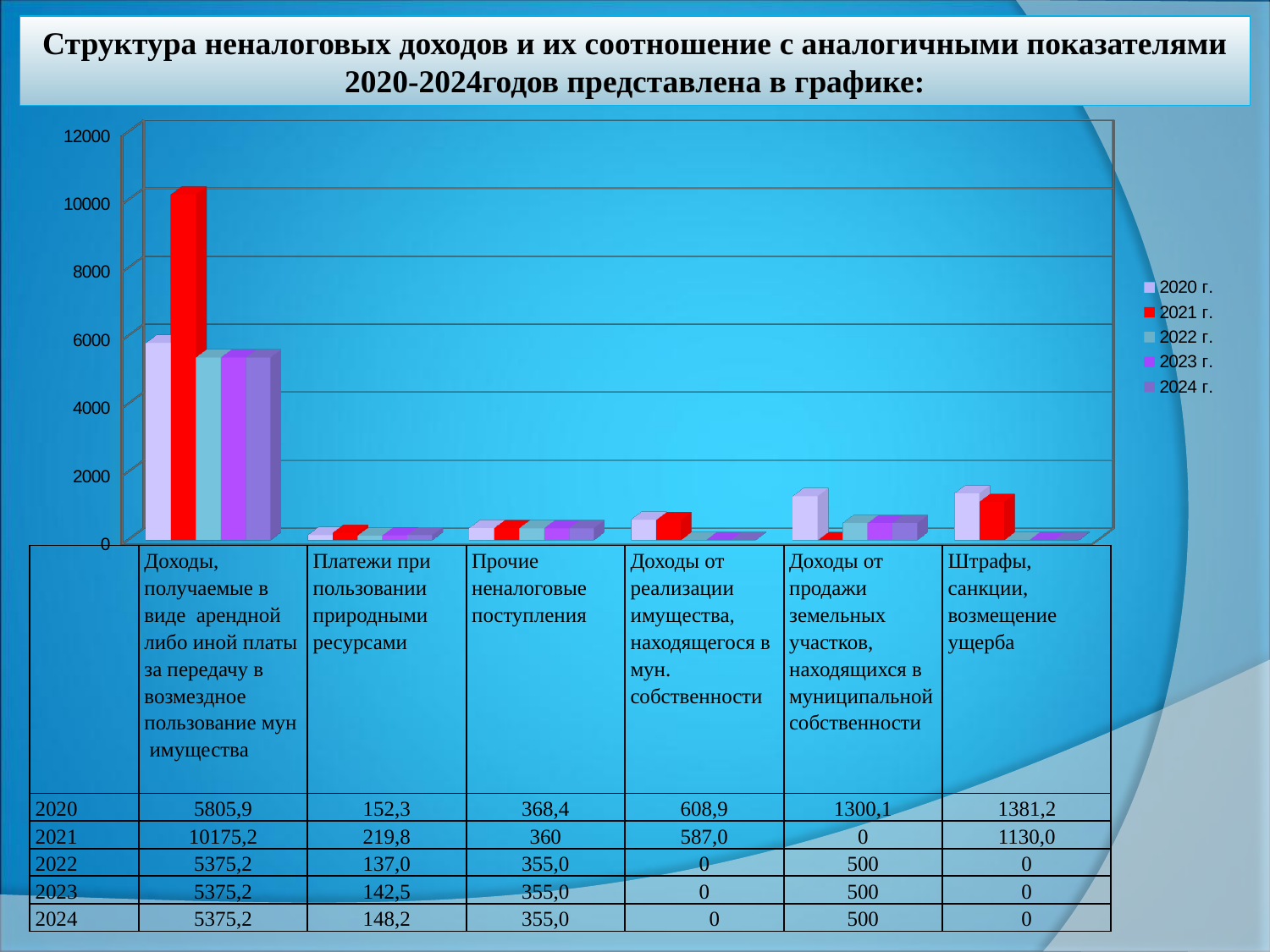
Which year has the highest value in the category «Доходы, получаемые в виде арендной либо иной платы за передачу в возмездное пользование мун имущества»? 2021 Which is larger in 2020: «Доходы от продажи земельных участков, находящихся в муниципальной собственности» or «Штрафы, санкции, возмещение ущерба»? Штрафы, санкции, возмещение ущерба Which colour represents the 2021 series in the legend? red Is the 2020 value for «Штрафы, санкции, возмещение ущерба» greater or less than 2000? less What kind of chart is shown on the slide? bar chart What is the value for 2021 in the category «Доходы, получаемые в виде арендной либо иной платы за передачу в возмездное пользование мун имущества»? 10175,2 What is the value for 2023 in the category «Платежи при пользовании природными ресурсами»? 142,5 How many categories are shown along the x axis of the chart? 6 What is the value for 2020 in the category «Штрафы, санкции, возмещение ущерба»? 1381,2 How many series does the legend list? 5 What is the difference between the 2021 and 2020 values in the category «Доходы, получаемые в виде арендной либо иной платы за передачу в возмездное пользование мун имущества»? 4369,3 Which year has the lowest value in the category «Платежи при пользовании природными ресурсами»? 2022